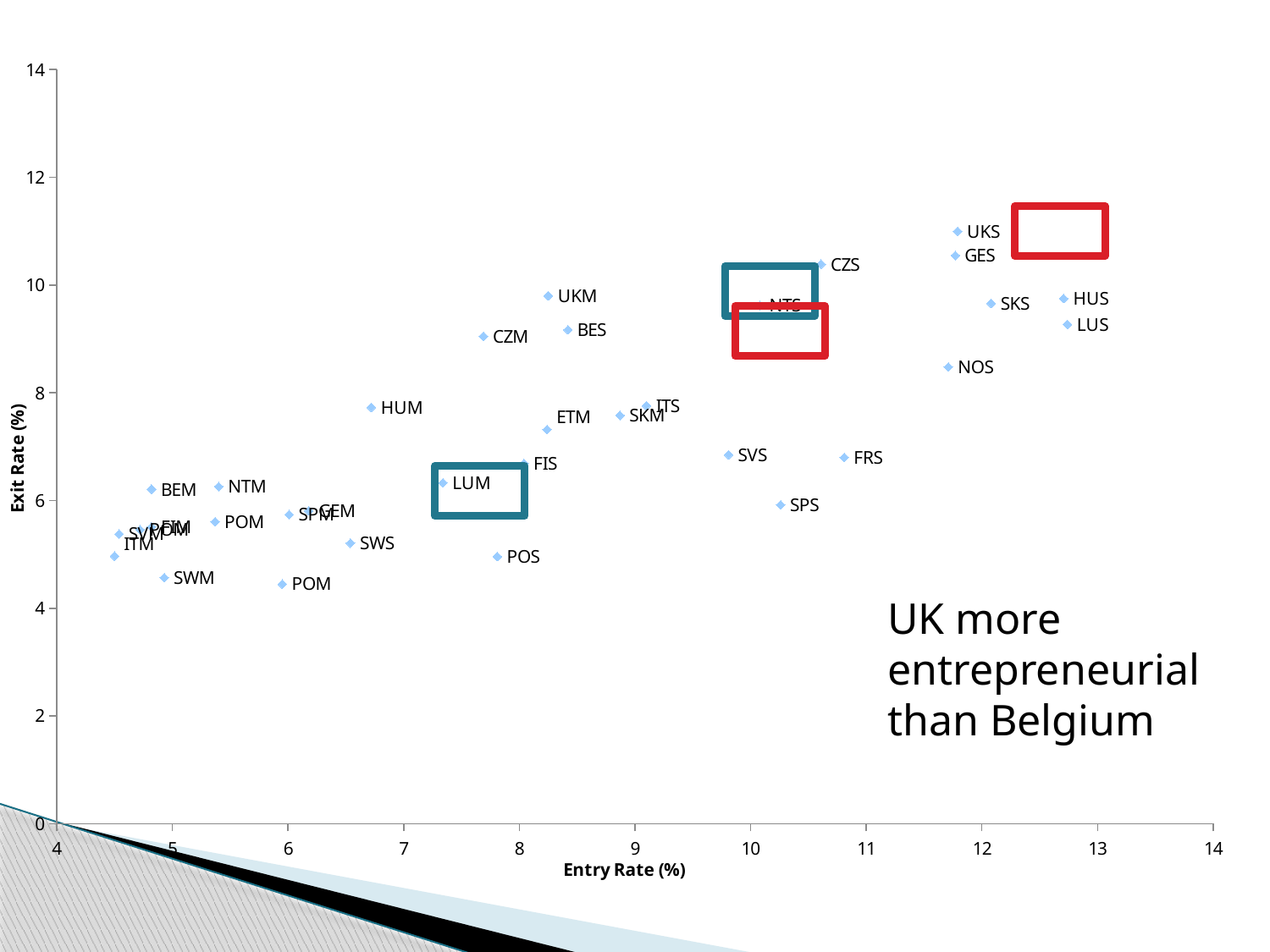
What is the title of the y axis? Exit Rate (%) Which point has the highest exit rate? UKS Is the entry rate for FRS greater or less than 10? greater Is the entry rate for HUM greater or less than 7? less What kind of chart is shown on the slide? scatter chart Is the exit rate for UKS greater or less than 10? greater Which has the higher exit rate, UKM or BES? UKM Which has the higher entry rate, SVS or FRS? FRS What is the title of the x axis? Entry Rate (%) Which has the higher exit rate, UKS or BEM? UKS